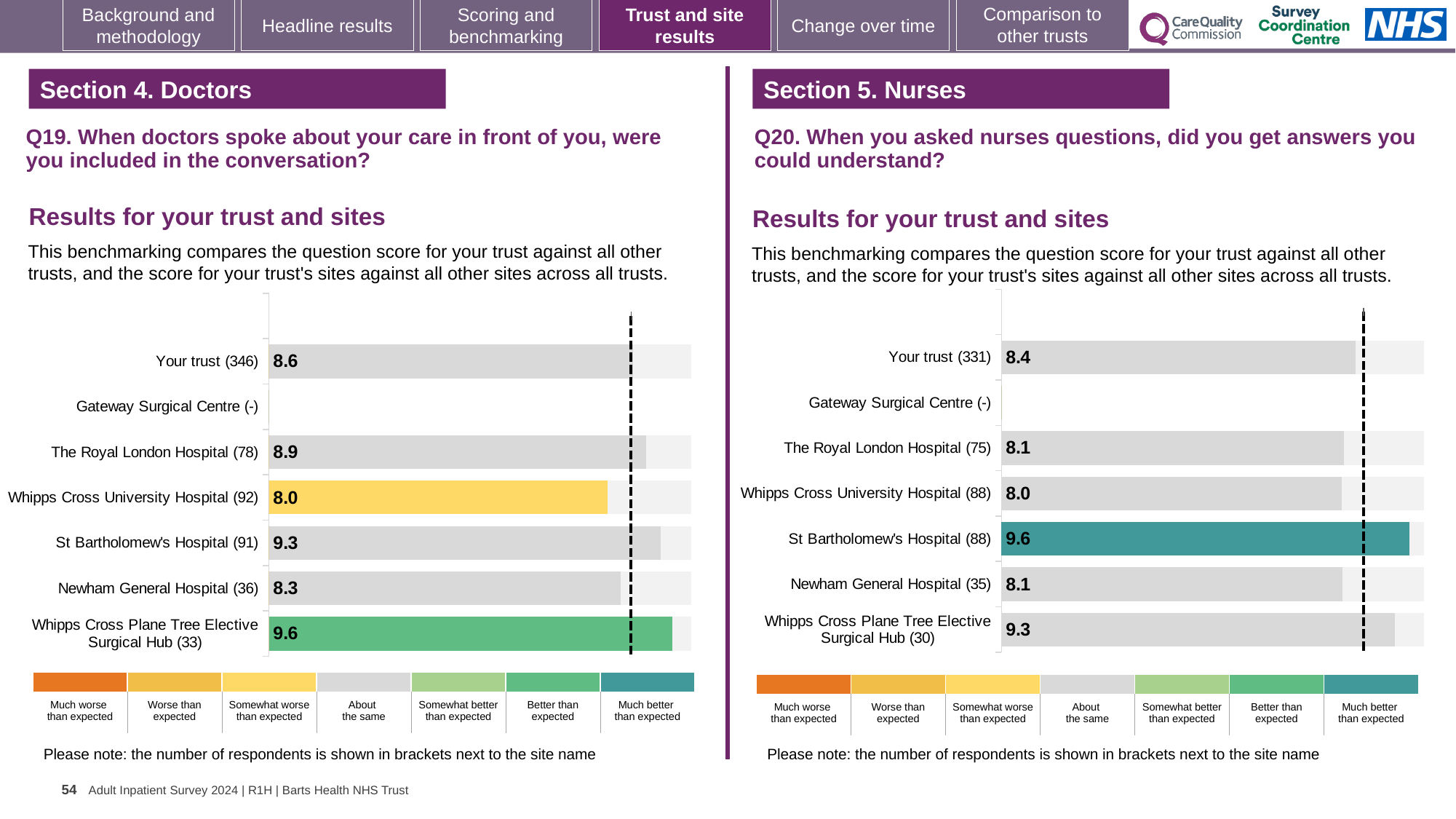
On the Q20 chart (right), which site has the highest score? St Bartholomew's Hospital (88) On the Q19 chart (left), which site has the highest score? Whipps Cross Plane Tree Elective Surgical Hub (33) On the Q19 chart (left), which site with a score shown has the lowest score? Whipps Cross University Hospital (92) On the Q20 chart (right), what is the score for St Bartholomew's Hospital (88)? 9.6 On the Q19 chart (left), what colour is the bar for Whipps Cross University Hospital (92)? Yellow On the Q20 chart (right), what is the score for Your trust (331)? 8.4 What type of chart is used on the Q20 chart (right)? Bar chart On the Q19 chart (left), what is the score for Whipps Cross University Hospital (92)? 8.0 On the Q19 chart (left), what is the score for Your trust (346)? 8.6 On the Q19 chart (left), what is the difference between the scores for St Bartholomew's Hospital (91) and Newham General Hospital (36)? 1.0 On the Q20 chart (right), which is larger: the score for The Royal London Hospital (75) or Whipps Cross Plane Tree Elective Surgical Hub (30)? Whipps Cross Plane Tree Elective Surgical Hub (30) On the Q20 chart (right), what is the difference between the scores for St Bartholomew's Hospital (88) and Whipps Cross University Hospital (88)? 1.6